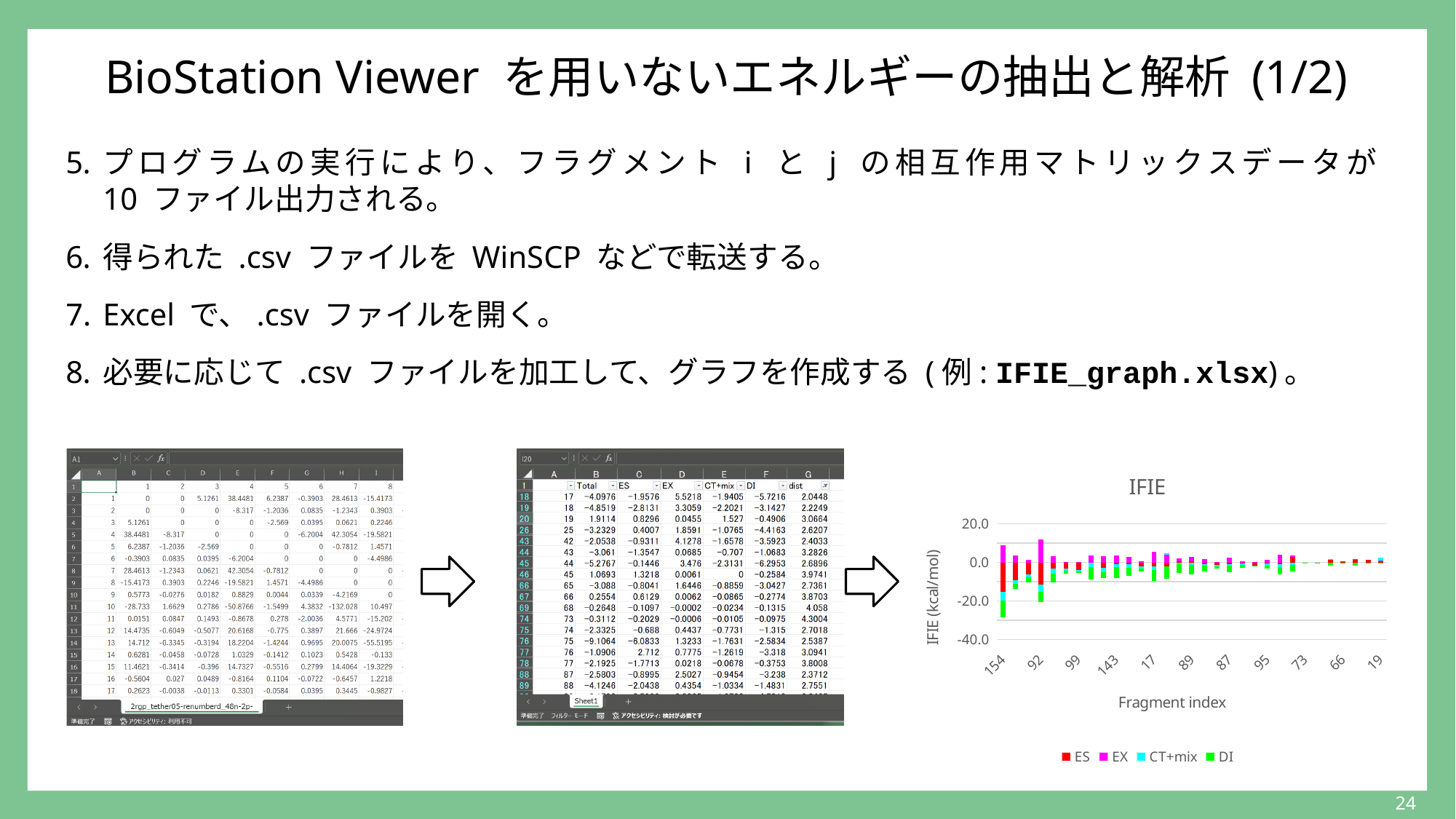
In the IFIE chart, which labelled fragment index has the bar extending furthest in the positive direction? 92 How many series does the legend of the IFIE chart list? 4 What kind of chart is the IFIE chart on the slide? stacked bar chart What is the lowest tick value shown on the y axis of the IFIE chart? -40.0 What is the title of the chart on the right of the slide? IFIE In the IFIE chart, does the stacked bar for fragment 154 extend below -20.0 on the y axis? yes In the IFIE chart, is the negative extent of the bar for fragment 154 larger or smaller than that of the bar for fragment 19? larger In the IFIE chart, which labelled fragment index has the bar extending furthest in the negative direction? 154 What is the y-axis label of the IFIE chart? IFIE (kcal/mol) In the IFIE chart, is the tallest positive stacked bar greater or less than 20.0? less In the IFIE chart, do the bar magnitudes generally get larger or smaller moving from left to right along the x axis? smaller How many fragment index labels are printed along the x axis of the IFIE chart? 11